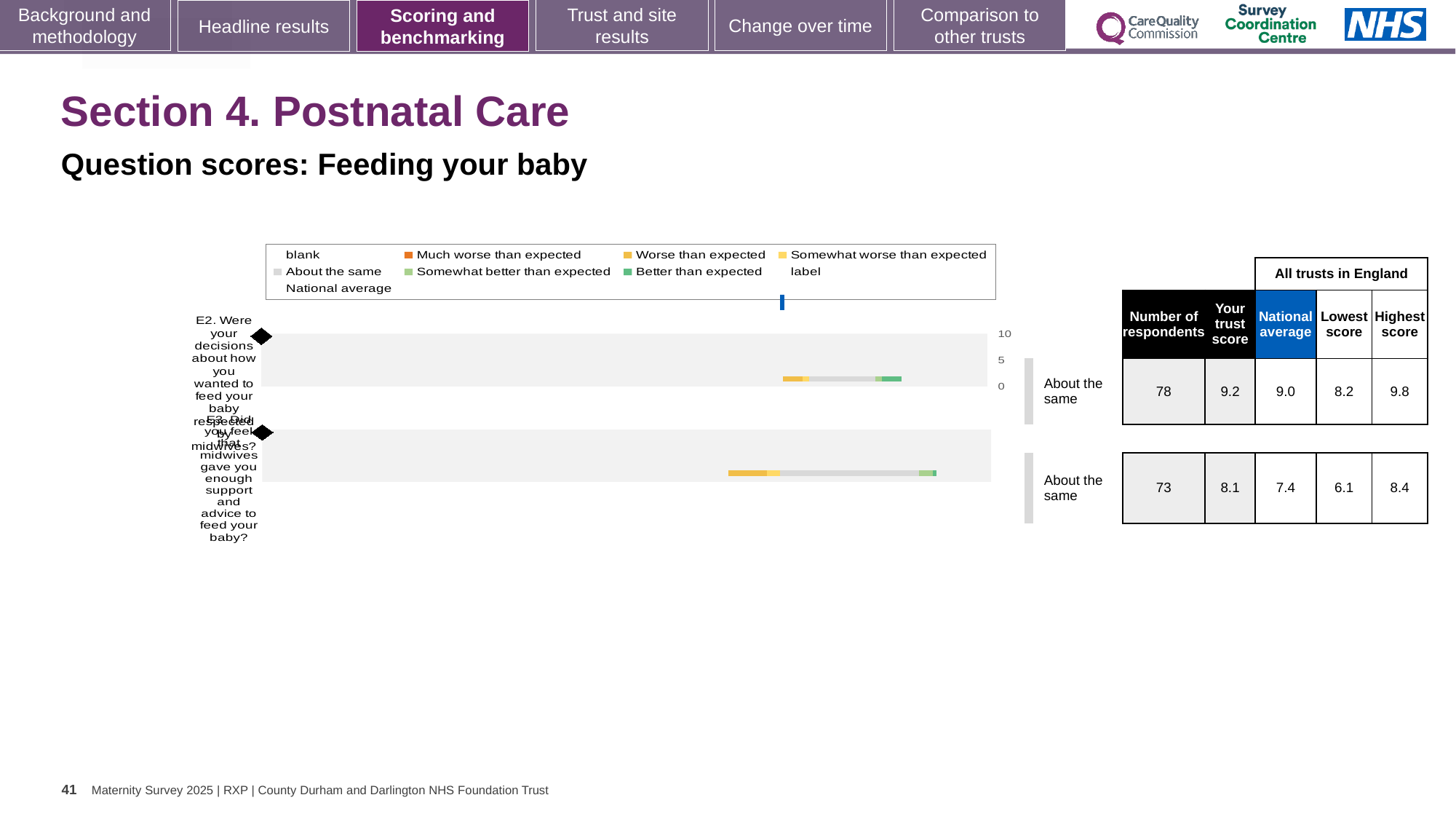
How many questions are plotted in the chart? 2 What is the national average score for question E2? 9.0 By how much does the trust score for E2 exceed the national average for E2? 0.2 Which question has the higher trust score, E2 or E3? E2 What is the highest score among all trusts in England for question E2? 9.8 How many respondents answered question E2 about decisions on how to feed your baby being respected by midwives? 78 How many respondents answered question E3? 73 What is the lowest score among all trusts in England for question E3? 6.1 What is the difference between the highest and lowest scores for question E3? 2.3 What kind of chart is used to show the question scores? Bar chart What benchmark category is shown for question E3? About the same What is the trust score for question E3 about midwives giving enough support and advice to feed your baby? 8.1